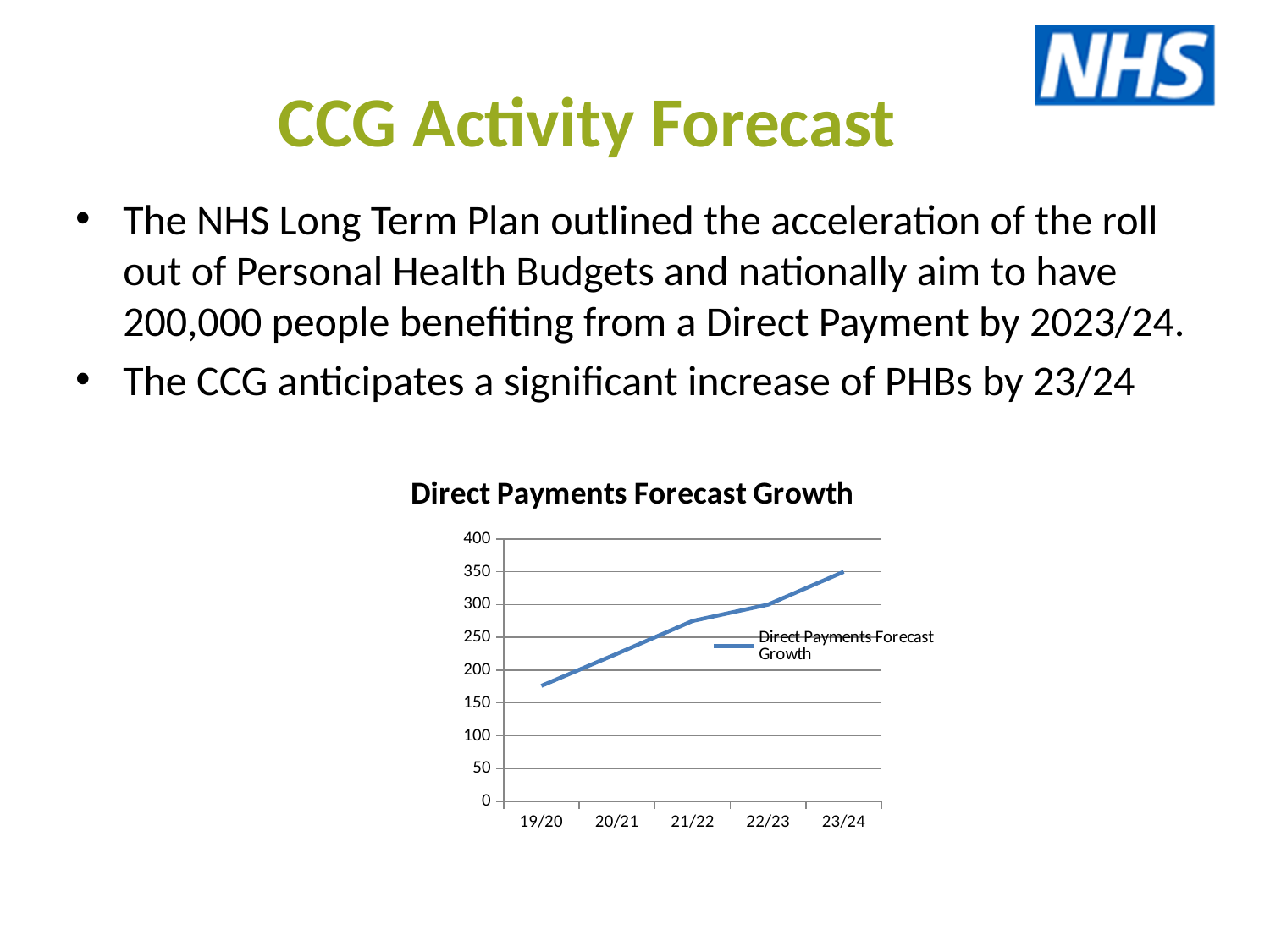
Which year has the lowest value? 19/20 Is the value for 19/20 greater or less than 200? less Do the values rise or fall from 19/20 to 23/24? rise Which year has the highest value? 23/24 What kind of chart is shown on the slide? line chart What is the title of the chart? Direct Payments Forecast Growth Which is larger, the value for 22/23 or the value for 20/21? 22/23 Is the value for 21/22 greater or less than 250? greater How many series does the legend list? 1 Is the value for 20/21 greater or less than 250? less What is the value for 23/24? 350 How many points are plotted along the x axis? 5